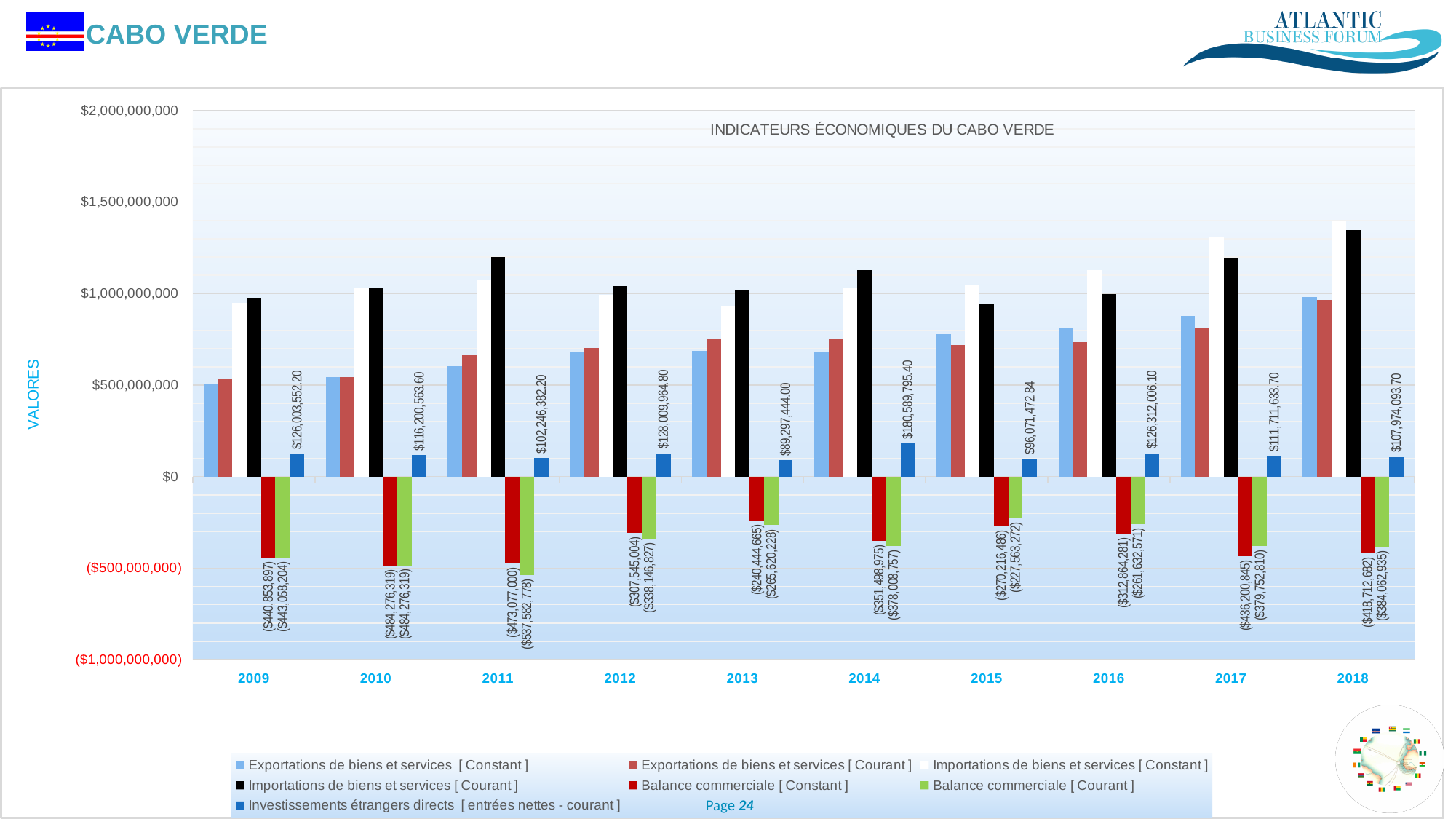
Which year has the larger value for Exportations de biens et services [Constant], 2009 or 2018? 2018 What is the difference between Investissements étrangers directs in 2014 and in 2013? $91,292,351.40 Is the value of Importations de biens et services [Courant] for 2018 greater or less than $1,000,000,000? greater What is the title of the chart? INDICATEURS ÉCONOMIQUES DU CABO VERDE What is the value of Balance commerciale [Courant] for 2011? ($537,582,778) How many years are shown on the x axis of the chart? 10 In which year is Investissements étrangers directs highest? 2014 In which year is Investissements étrangers directs lowest? 2013 How many series does the legend list? 7 What is the value of Investissements étrangers directs for 2014? $180,589,795.40 What is the value of Balance commerciale [Constant] for 2013? ($240,444,665) What kind of chart is shown on the slide? bar chart